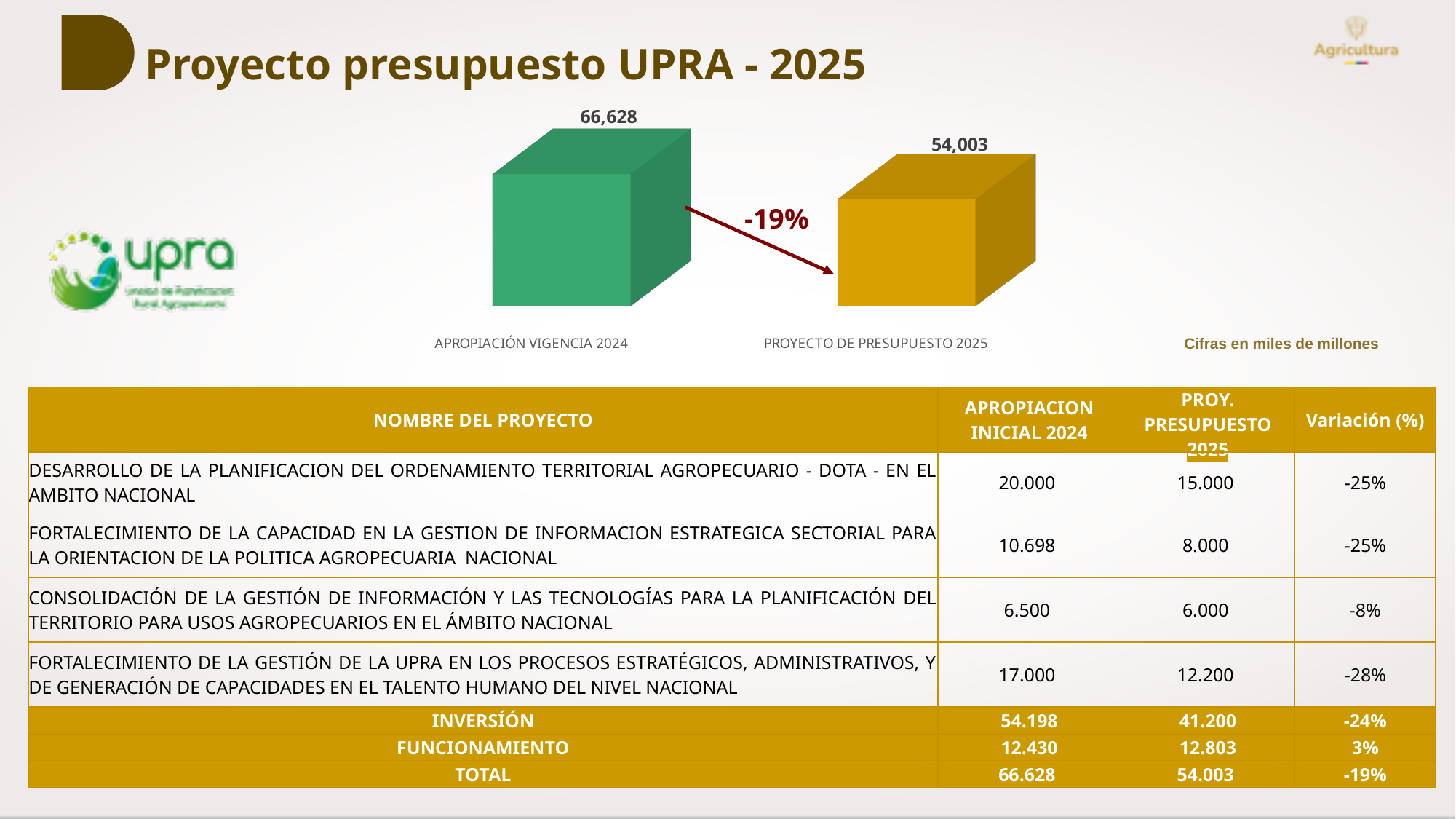
What kind of chart is shown on the slide? Bar chart Which is larger in the chart, the value for APROPIACIÓN VIGENCIA 2024 or the value for PROYECTO DE PRESUPUESTO 2025? APROPIACIÓN VIGENCIA 2024 Which category in the chart has the lowest value? PROYECTO DE PRESUPUESTO 2025 What is the difference between the value for APROPIACIÓN VIGENCIA 2024 and the value for PROYECTO DE PRESUPUESTO 2025 in the chart? 12,625 Which category in the chart has the highest value? APROPIACIÓN VIGENCIA 2024 What percentage change is annotated on the arrow between the two bars in the chart? -19% What is the value shown for PROYECTO DE PRESUPUESTO 2025 in the chart? 54,003 Do the values in the chart rise or fall from APROPIACIÓN VIGENCIA 2024 to PROYECTO DE PRESUPUESTO 2025? Fall How many categories are plotted in the chart? 2 What colour is the bar for PROYECTO DE PRESUPUESTO 2025 in the chart? Yellow What is the value shown for APROPIACIÓN VIGENCIA 2024 in the chart? 66,628